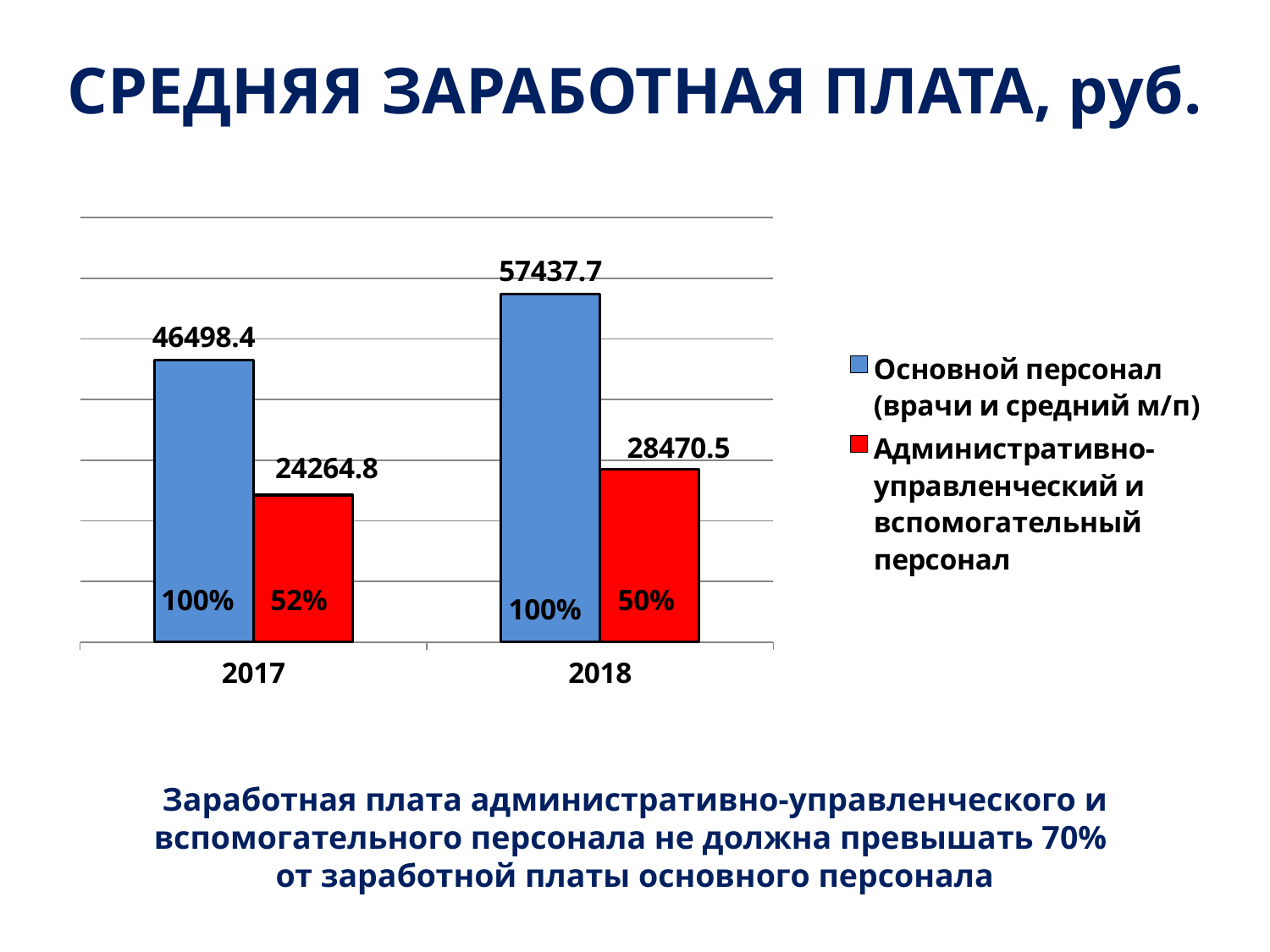
What is the average salary of the main staff (Основной персонал) in 2017? 46498.4 What percentage label is shown on the administrative and support staff bar for 2017? 52% What is the average salary of the administrative and support staff (Административно-управленческий и вспомогательный персонал) in 2018? 28470.5 Which bar has the highest value on the chart? Основной персонал (врачи и средний м/п), 2018 How many series does the legend list? 2 What percentage label is shown on the administrative and support staff bar for 2018? 50% Which bar has the lowest value on the chart? Административно-управленческий и вспомогательный персонал, 2017 What type of chart is shown on the slide? Bar chart What is the average salary of the main staff (Основной персонал) in 2018? 57437.7 What is the difference between the main staff salary and the administrative and support staff salary in 2018? 28967.2 What is the average salary of the administrative and support staff in 2017? 24264.8 Is the main staff salary higher in 2017 or in 2018? 2018